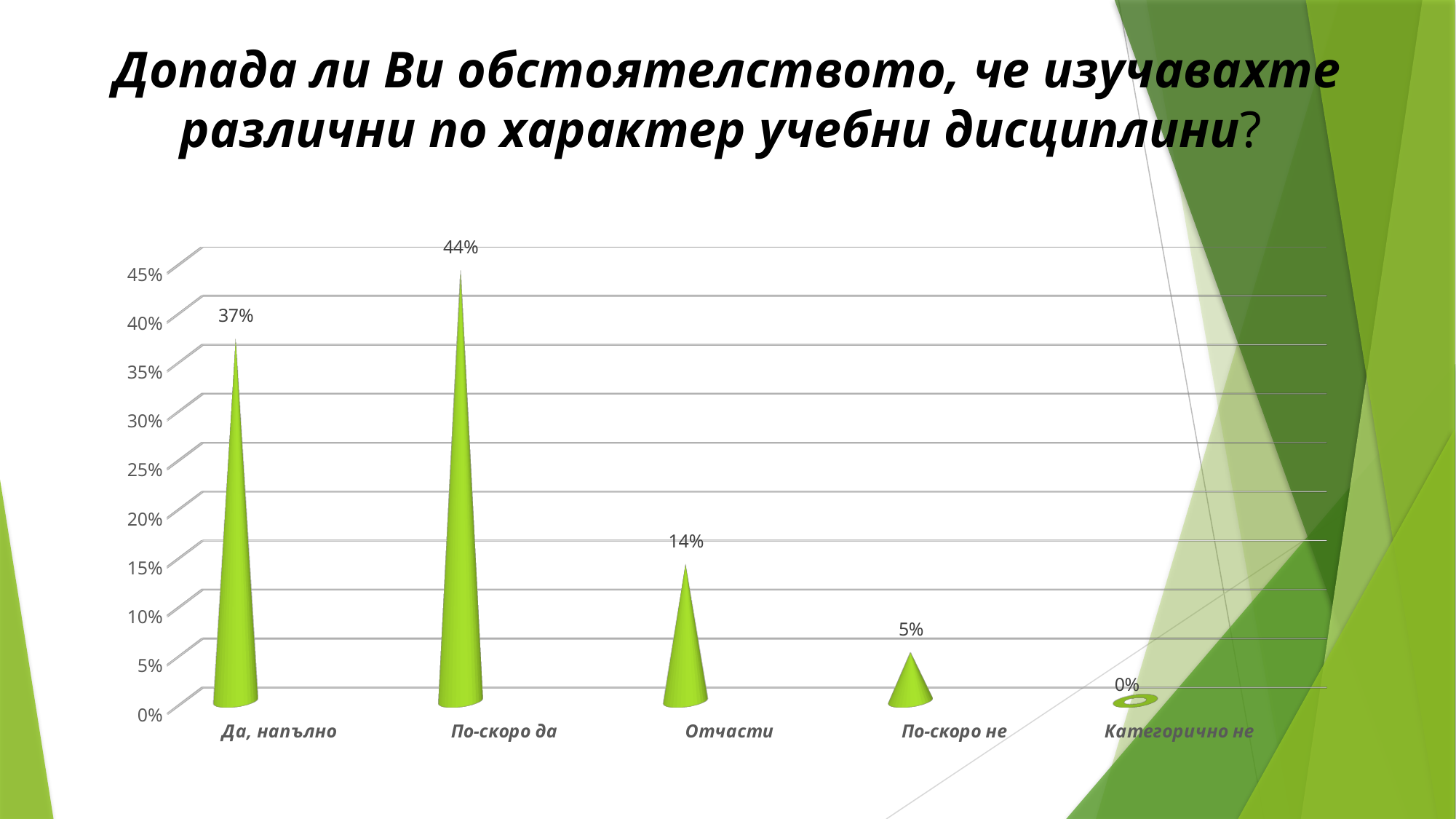
Which category has the lowest value? Категорично не What is the value for "Да, напълно"? 37% What kind of chart is shown on the slide? Bar chart What is the value for "По-скоро да"? 44% What is the value for "Категорично не"? 0% Do the values rise or fall from "По-скоро да" to "Категорично не" along the x axis? Fall What is the difference between the values for "По-скоро да" and "Да, напълно"? 7% Which category has the highest value? По-скоро да How many categories are shown on the x axis? 5 What is the value for "Отчасти"? 14% What is the value for "По-скоро не"? 5% Which is larger, the value for "Отчасти" or the value for "По-скоро не"? Отчасти